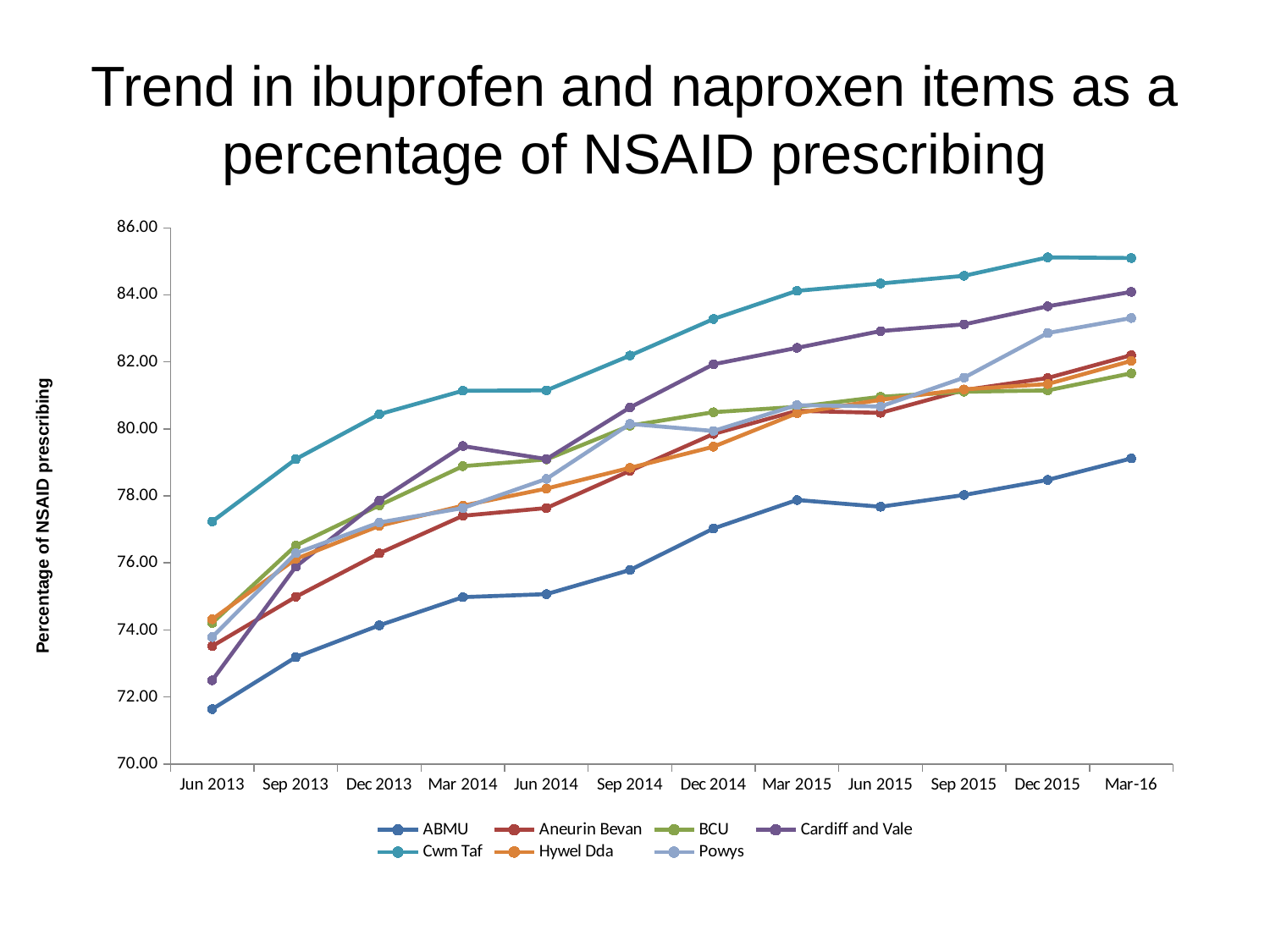
Is the value for ABMU at Jun 2013 greater or less than 72.00? less How many time points are shown along the x axis? 12 Which series has the lowest value at Mar-16? ABMU Is the value for Cwm Taf at Mar-16 greater or less than 84.00? greater What is the title of the y axis? Percentage of NSAID prescribing Which series has the highest value at Mar-16? Cwm Taf What kind of chart is shown on the slide? line chart Is the value for Cardiff and Vale at Jun 2013 greater or less than 74.00? less Which series has the lowest value at Jun 2013? ABMU At Jun 2013, which is larger: the value for Cwm Taf or the value for ABMU? Cwm Taf How many series does the legend list? 7 Does the ABMU line rise or fall from Jun 2013 to Mar-16? rise